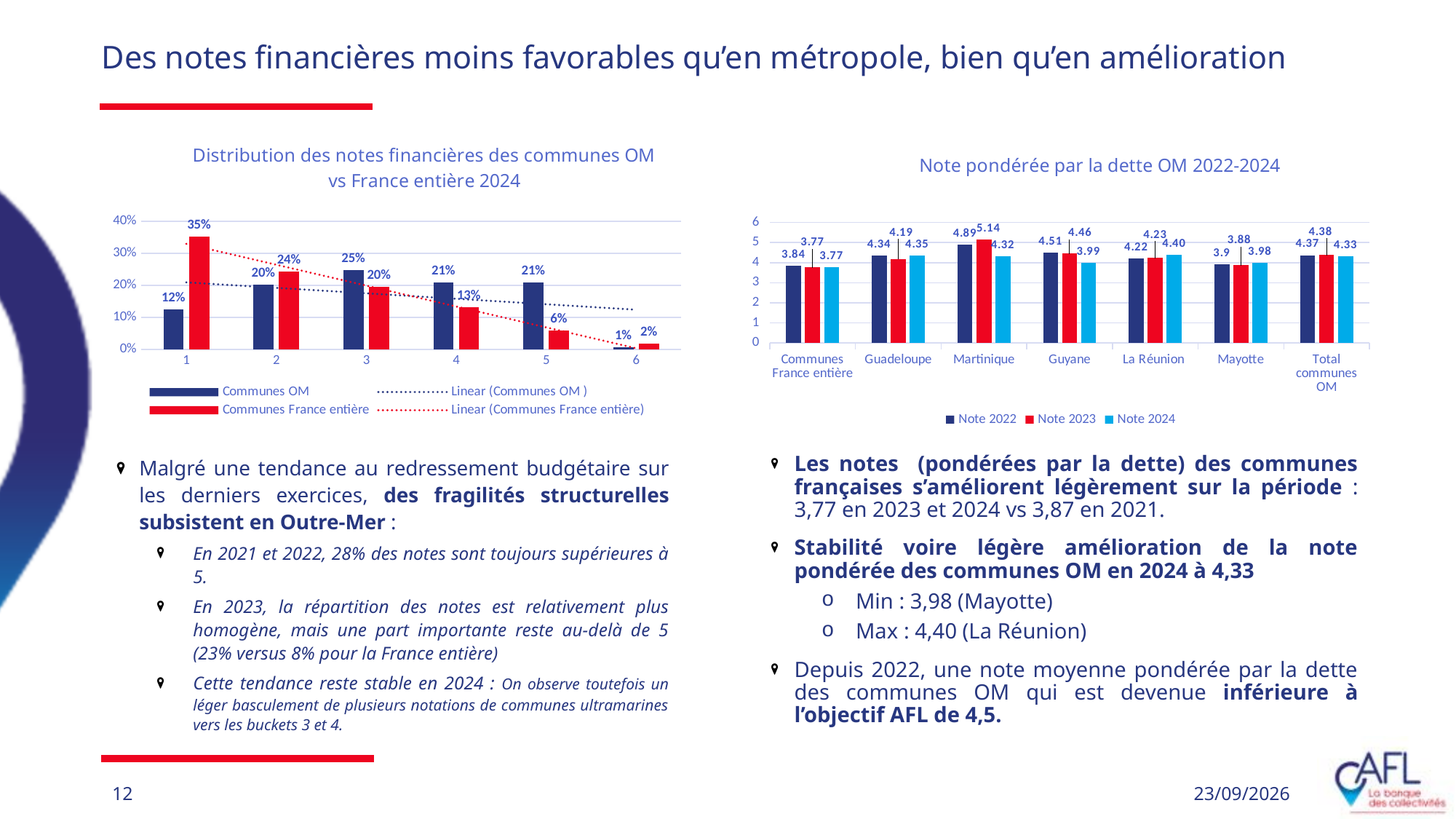
In the chart 'Distribution des notes financières des communes OM vs France entière 2024', what is the value for Communes France entière at category 1? 35% In the chart 'Distribution des notes financières des communes OM vs France entière 2024', which category has the highest value for Communes France entière? 1 In the chart 'Note pondérée par la dette OM 2022-2024', what is the Note 2023 value for Martinique? 5.14 In the chart 'Distribution des notes financières des communes OM vs France entière 2024', do the Communes France entière values rise or fall from category 1 to category 6? fall In the chart 'Note pondérée par la dette OM 2022-2024', which is larger for Guyane: Note 2022 or Note 2024? Note 2022 In the chart 'Distribution des notes financières des communes OM vs France entière 2024', what is the value for Communes OM at category 3? 25% In the chart 'Note pondérée par la dette OM 2022-2024', how many series does the legend list? 3 In the chart 'Note pondérée par la dette OM 2022-2024', which category has the lowest Note 2024 value? Communes France entière In the chart 'Distribution des notes financières des communes OM vs France entière 2024', how many categories are shown on the x axis? 6 In the chart 'Distribution des notes financières des communes OM vs France entière 2024', what is the difference between Communes OM and Communes France entière at category 5? 15% What kind of chart is 'Note pondérée par la dette OM 2022-2024'? bar chart In the chart 'Note pondérée par la dette OM 2022-2024', what is the Note 2024 value for Total communes OM? 4.33